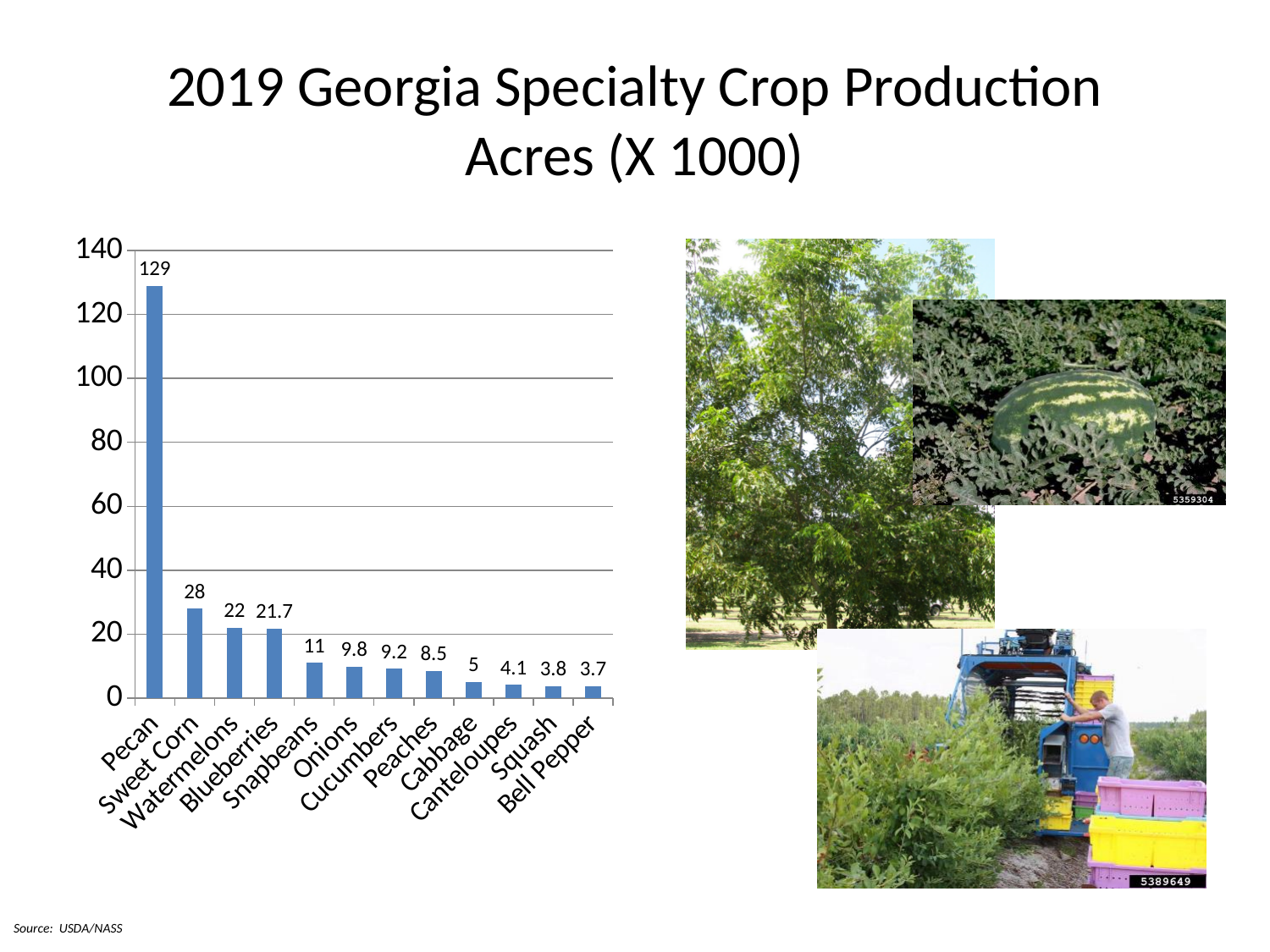
What is the value for Blueberries? 21.7 How many crops are shown on the chart? 12 What is the value for Pecan? 129 What kind of chart is shown on the slide? bar chart Is the value for Sweet Corn greater or less than 20? greater What is the title of the chart on the slide? 2019 Georgia Specialty Crop Production Acres (X 1000) Which crop has the highest value? Pecan What is the difference between the values for Watermelons and Blueberries? 0.3 What is the difference between the values for Pecan and Sweet Corn? 101 Which crop has the lowest value? Bell Pepper What is the value for Cucumbers? 9.2 Which is larger, the value for Onions or the value for Peaches? Onions